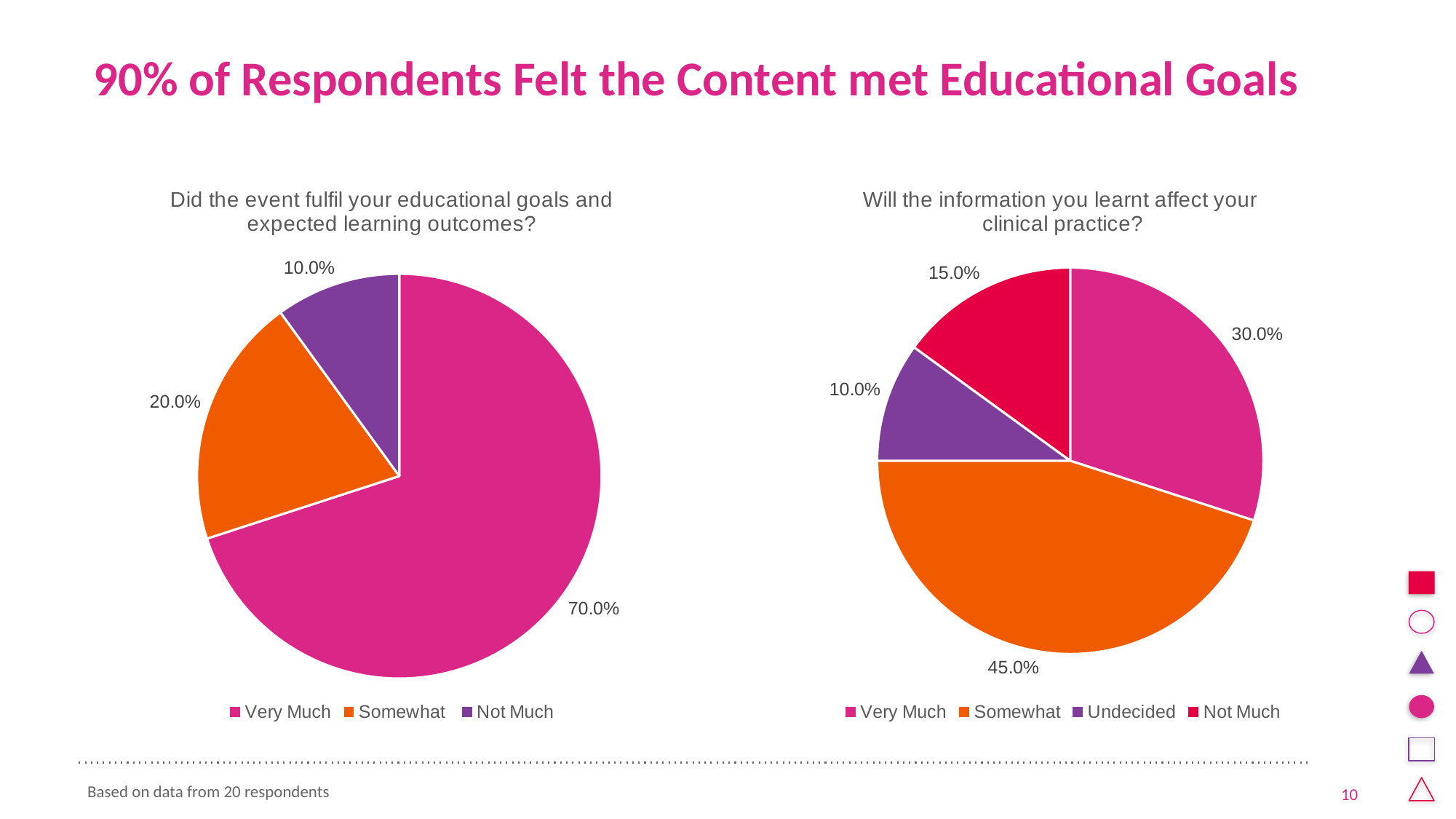
In the chart titled "Did the event fulfil your educational goals and expected learning outcomes?", what share of respondents answered Very Much? 70.0% What type of chart is used on the right side of the slide? Pie chart In the chart titled "Will the information you learnt affect your clinical practice?", what share of respondents answered Somewhat? 45.0% In the chart titled "Did the event fulfil your educational goals and expected learning outcomes?", what share of respondents answered Somewhat? 20.0% In the chart titled "Will the information you learnt affect your clinical practice?", which is larger, Very Much or Not Much? Very Much In the chart titled "Will the information you learnt affect your clinical practice?", which response has the largest slice? Somewhat In the chart titled "Will the information you learnt affect your clinical practice?", what share of respondents answered Not Much? 15.0% In the chart titled "Did the event fulfil your educational goals and expected learning outcomes?", which response has the smallest slice? Not Much In the chart titled "Did the event fulfil your educational goals and expected learning outcomes?", what is the difference between the Very Much and Somewhat shares? 50.0% In the chart titled "Will the information you learnt affect your clinical practice?", what is the combined share of Very Much and Somewhat? 75.0% In the chart titled "Did the event fulfil your educational goals and expected learning outcomes?", how many slices does the pie have? 3 In the chart titled "Will the information you learnt affect your clinical practice?", how many entries does the legend list? 4